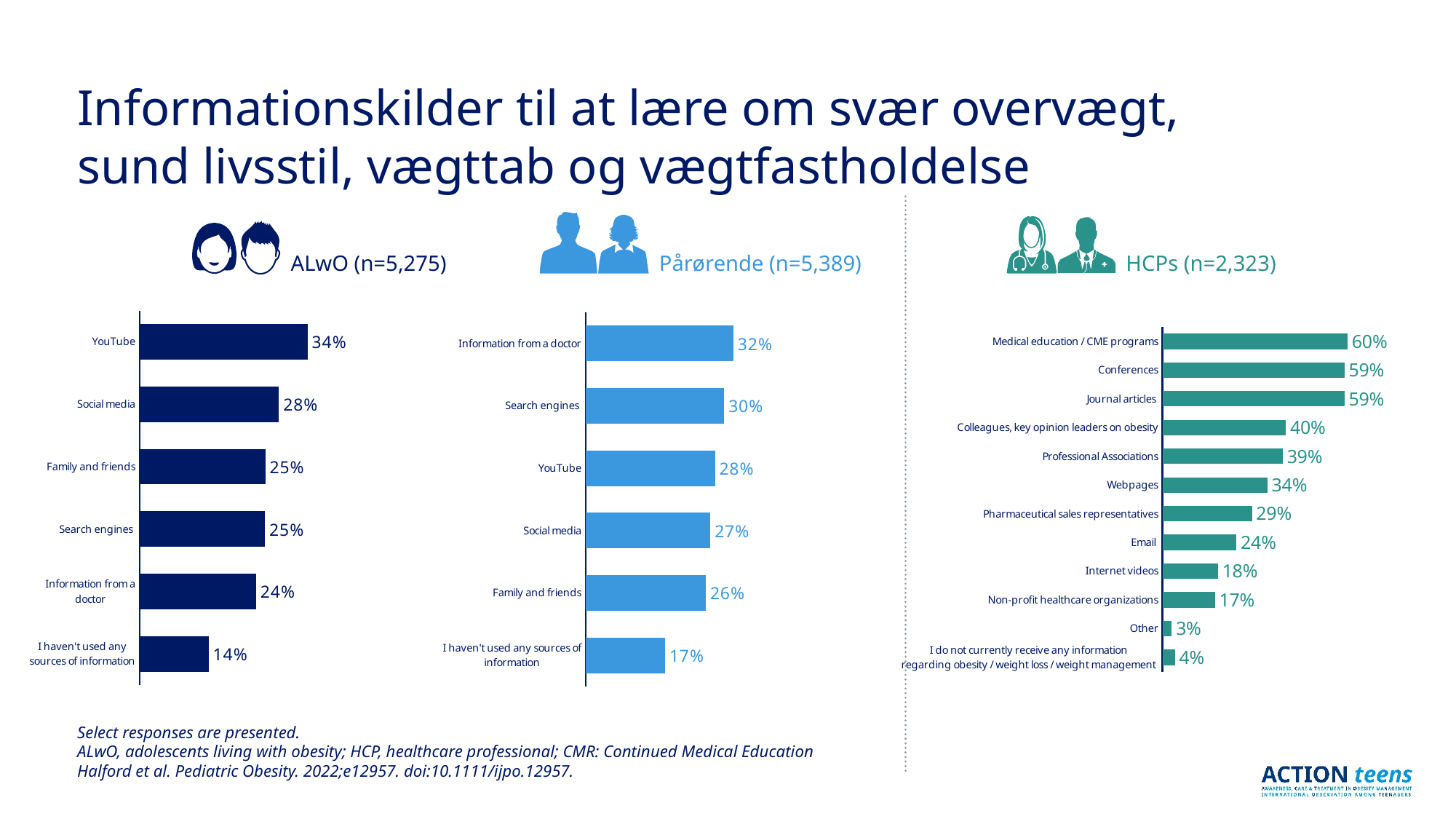
In the HCPs (n=2,323) chart, what is the value for Webpages? 34% In the HCPs (n=2,323) chart, which category has the highest value? Medical education / CME programs In the HCPs (n=2,323) chart, how many categories are shown? 12 In the Pårørende (n=5,389) chart, which category has the highest value? Information from a doctor In the ALwO (n=5,275) chart, which category has the lowest value? I haven't used any sources of information In the ALwO (n=5,275) chart, what is the value for YouTube? 34% In the ALwO (n=5,275) chart, how many categories are shown? 6 In the Pårørende (n=5,389) chart, which is larger: YouTube or Family and friends? YouTube What type of chart is the HCPs (n=2,323) chart? Bar chart In the HCPs (n=2,323) chart, what is the difference between Colleagues, key opinion leaders on obesity and Email? 16% In the Pårørende (n=5,389) chart, what is the value for Search engines? 30% In the ALwO (n=5,275) chart, what is the difference between Social media and Information from a doctor? 4%